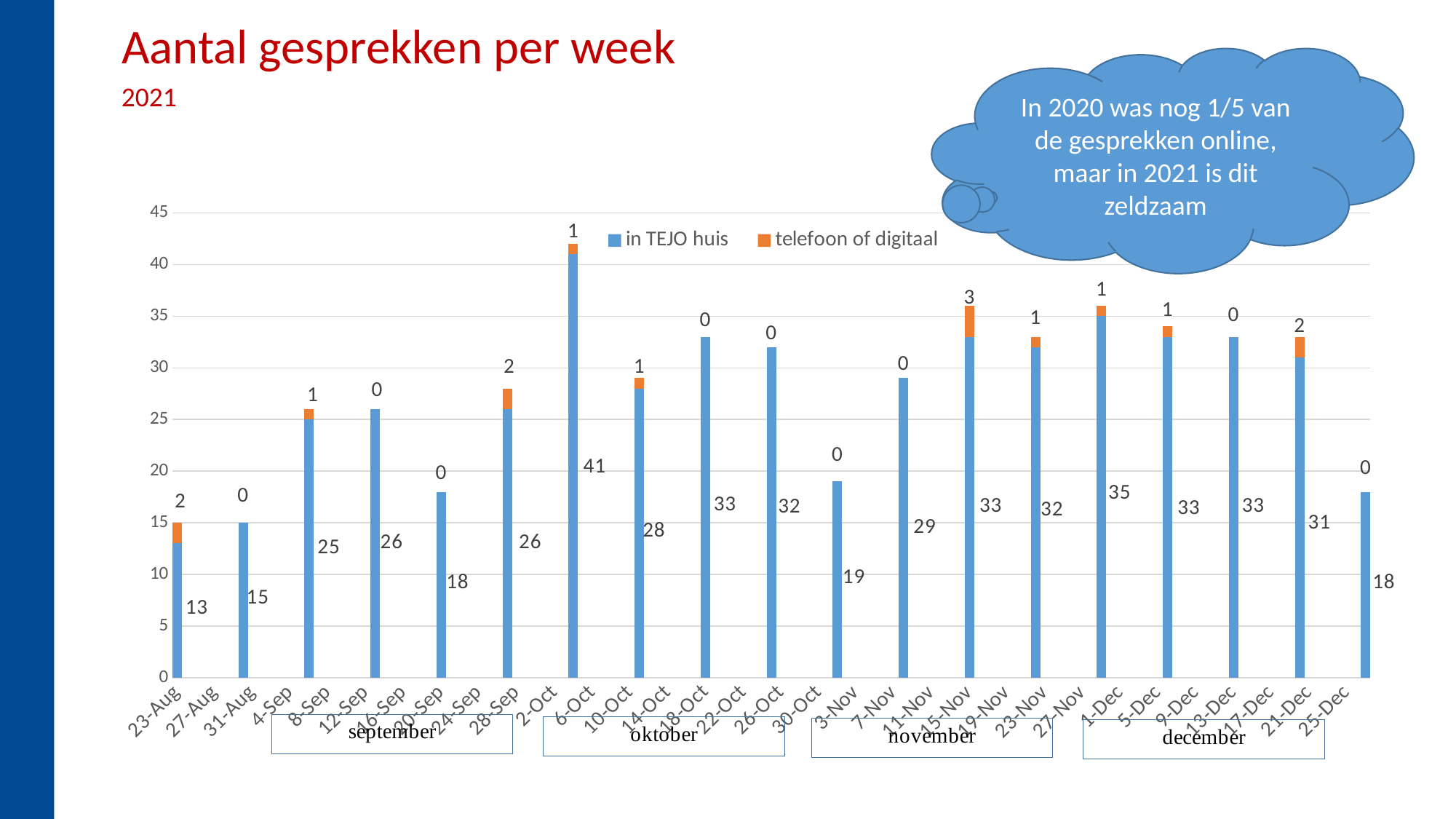
What is the lowest 'in TEJO huis' value shown in the chart? 13 How many series does the legend list? 2 What is the highest 'telefoon of digitaal' value shown in the chart? 3 What is the title of the chart? Aantal gesprekken per week How many bars are plotted in the chart? 19 What is the 'telefoon of digitaal' value for the first bar (23-Aug)? 2 What is the total of the tallest stacked bar in the chart? 42 What type of chart is shown on the slide? bar chart What is the highest 'in TEJO huis' value shown in the chart? 41 What is the total of the stacked bar at 23-Aug? 15 What is the 'in TEJO huis' value for the first bar (23-Aug)? 13 What are the two series named in the legend? in TEJO huis; telefoon of digitaal